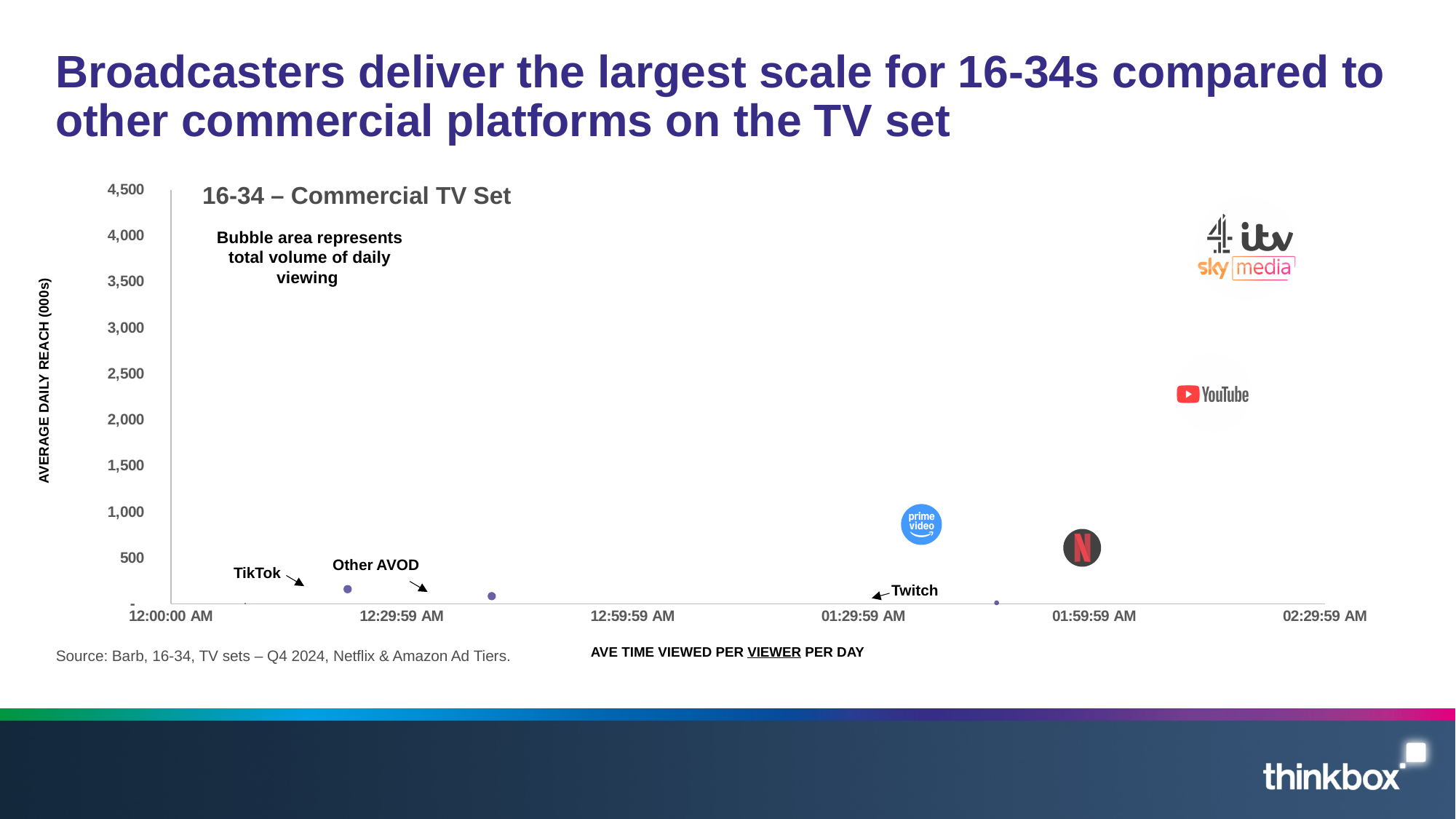
Which has the higher average time viewed per viewer per day, Netflix or Prime Video? Netflix Is the average daily reach for YouTube greater or less than 2,000? greater Which has the higher average daily reach, YouTube or Netflix? YouTube Which platform has the lowest average daily reach in the chart? Twitch Is the average daily reach for TikTok greater or less than 500? less Is the average daily reach for Netflix greater or less than 1,000? less What is the title of the chart? 16-34 – Commercial TV Set What kind of chart is shown on the slide? Bubble chart What does the bubble area represent in the chart? Total volume of daily viewing Which platform has the highest average daily reach in the chart? Broadcasters (Channel 4, ITV, Sky Media) How many platforms are plotted in the chart? 7